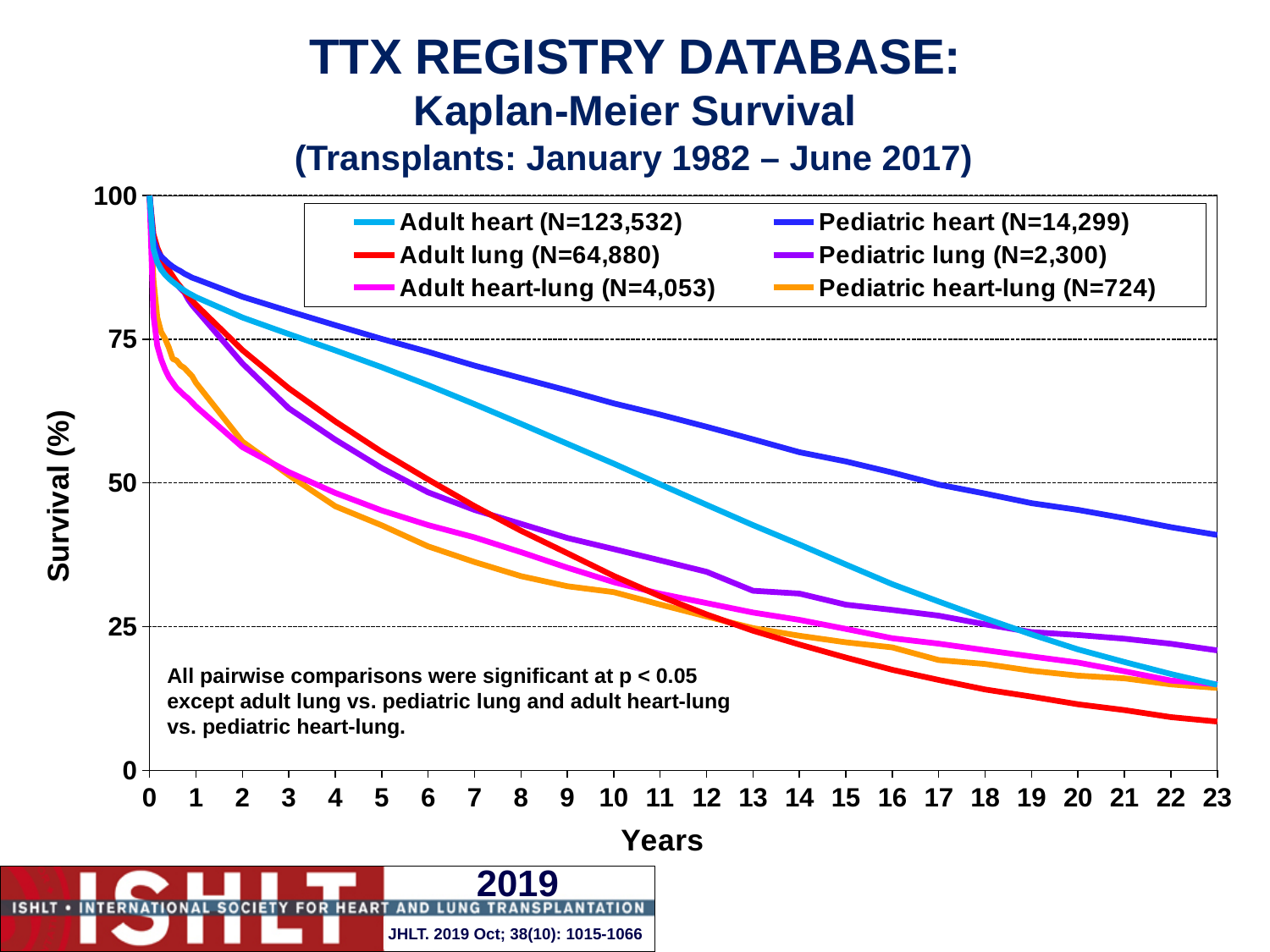
What is the N shown in the legend for Adult heart? N=123,532 Is the survival value for Adult lung at 23 years greater or less than 25? less Is the survival value for Adult heart-lung at 1 year greater or less than 75? less At 23 years, which series has the lowest survival? Adult lung At 20 years, which has higher survival: Pediatric heart or Adult heart? Pediatric heart How many series does the legend list? 6 What kind of chart is shown on the slide? line chart At 23 years, which series has the highest survival? Pediatric heart Is the survival value for Pediatric heart at 23 years greater or less than 25? greater Do the survival curves rise or fall as the years increase? fall